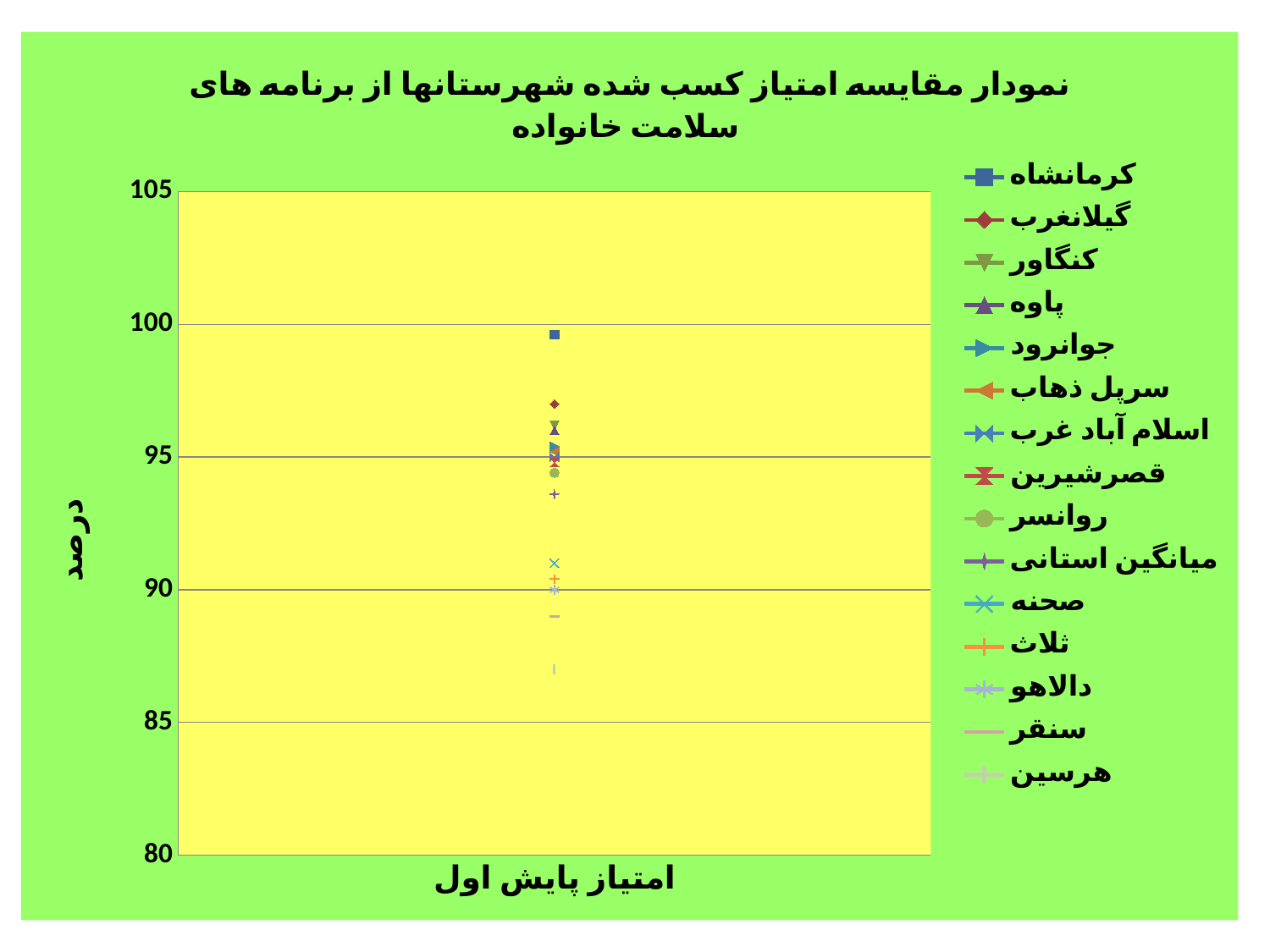
What is the label on the horizontal axis? امتیاز پایش اول Which series has the highest value? کرمانشاه Is the value for گیلانغرب greater or less than 95? greater Is the value for میانگین استانی greater or less than 95? less Is the value for کرمانشاه greater or less than 95? greater Which is larger, the value for گیلانغرب or the value for صحنه? گیلانغرب How many series does the legend list? 15 Which series has the lowest value? هرسین What is the label on the vertical axis? درصد